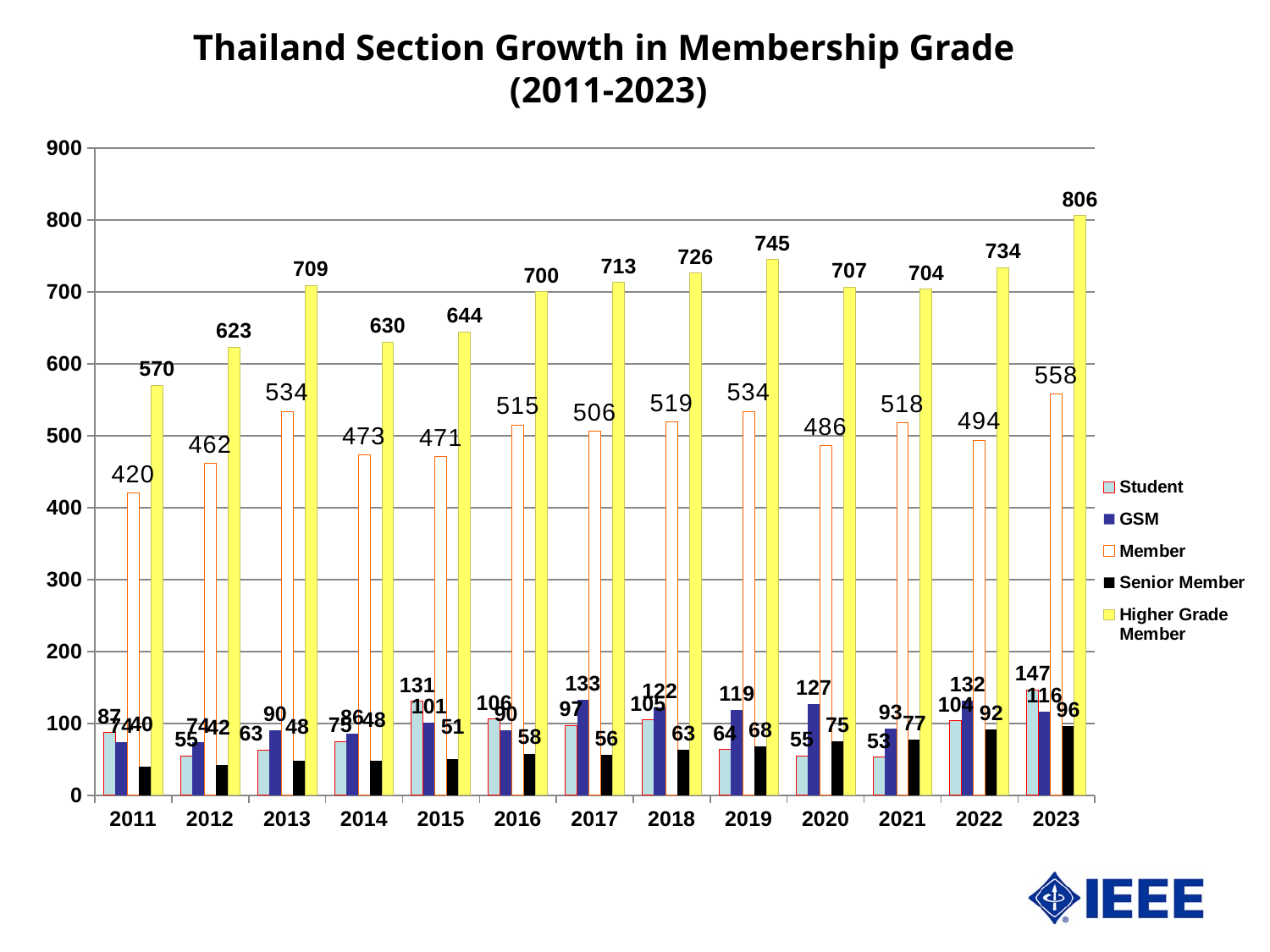
What is the value for Senior Member in 2022? 92 Do the Senior Member values generally rise or fall from 2011 to 2023? rise What is the difference between the Higher Grade Member values in 2023 and 2011? 236 What is the value for Member in 2019? 534 What kind of chart is shown on the slide? bar chart What is the value for Student in 2015? 131 What is the value for Higher Grade Member in 2023? 806 How many years are shown on the x axis? 13 In which year is the Member value lowest? 2011 In which year is the Higher Grade Member value highest? 2023 How many series does the legend list? 5 In 2017, which is larger: Student or GSM? GSM